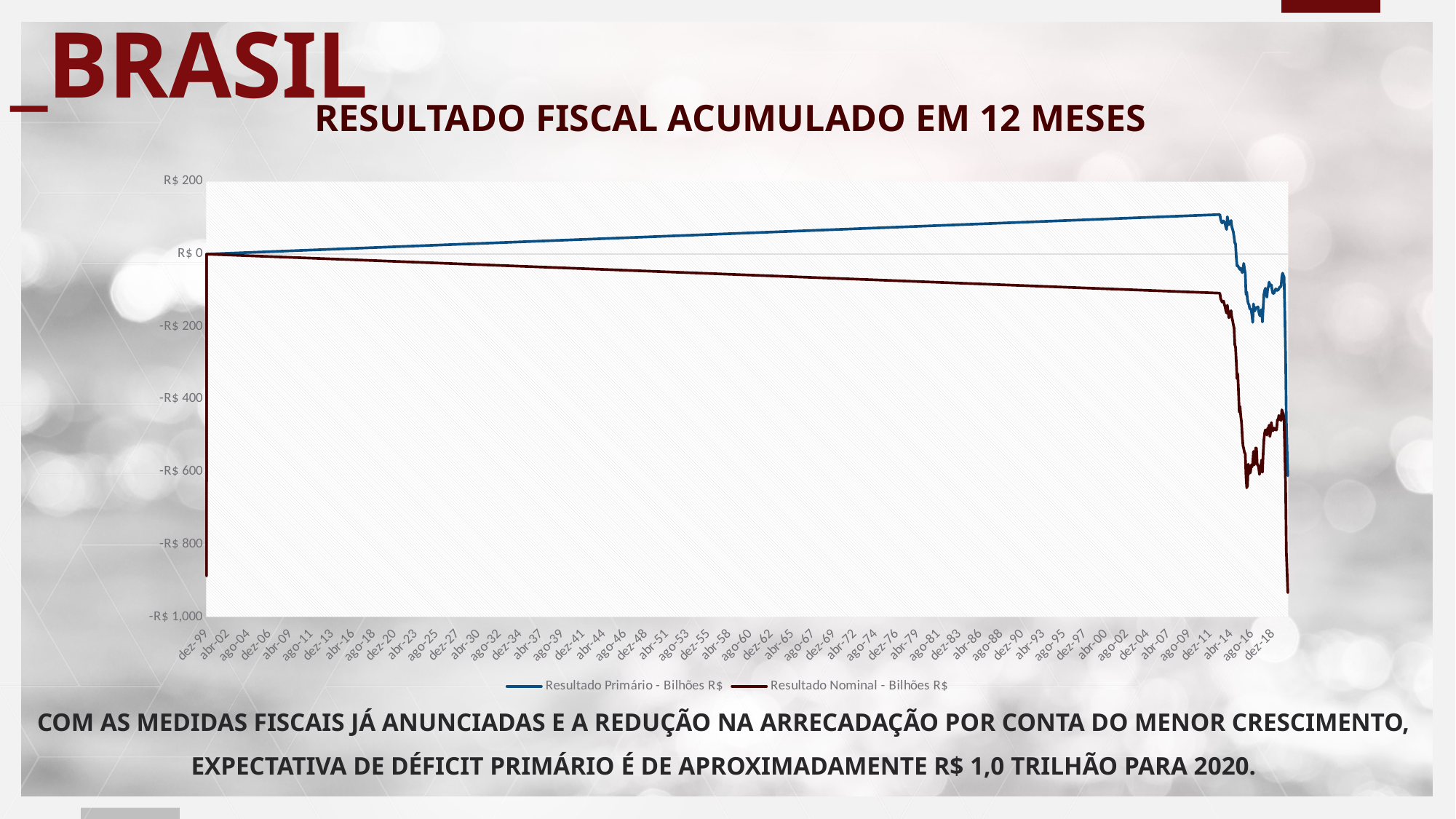
Which series is drawn in dark red according to the legend? Resultado Nominal - Bilhões R$ Does the Resultado Nominal series rise or fall sharply at the right end of the chart? Fall What is the title of the chart? RESULTADO FISCAL ACUMULADO EM 12 MESES What is the lowest value shown on the vertical axis? -R$ 1,000 Is the peak value of the Resultado Primário series greater or less than R$ 0? greater Which series has the higher value at the point where both lines are at their flattest, before the sharp drop? Resultado Primário Which series ends at a lower value at the right end of the chart, Resultado Primário or Resultado Nominal? Resultado Nominal Is the final value of the Resultado Nominal series greater or less than -R$ 800? less What is the highest value shown on the vertical axis? R$ 200 What kind of chart is shown on the slide? Line chart Is the final value of the Resultado Primário series greater or less than -R$ 400? less How many series does the chart legend list? 2